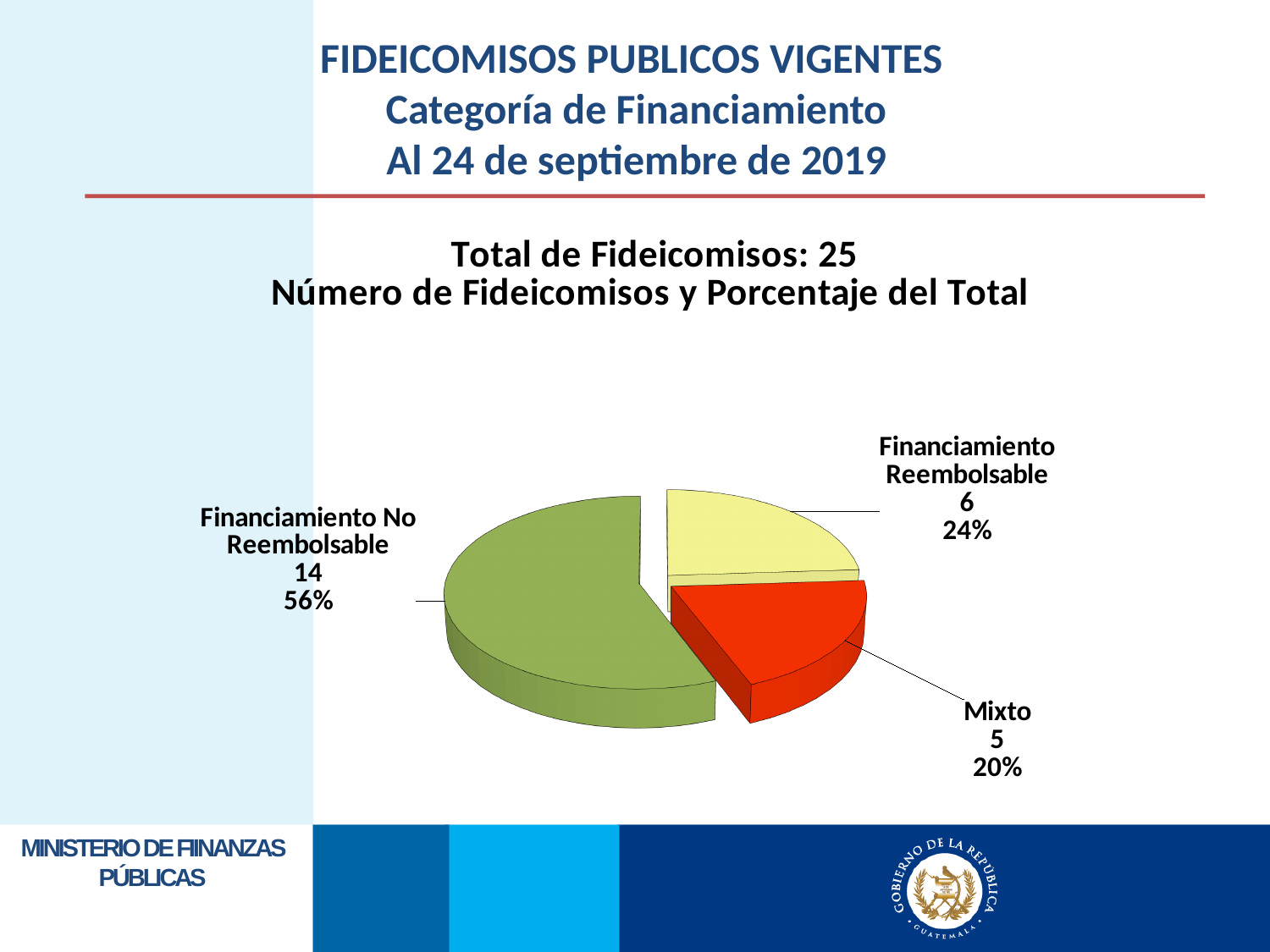
What share of the pie does Financiamiento No Reembolsable hold? 56% What percentage of the total does Financiamiento Reembolsable represent? 24% What is the total number of fideicomisos shown on the slide? 25 What kind of chart is shown on the slide? pie chart How many fideicomisos are in the Mixto category? 5 Which category has the smallest slice of the pie? Mixto How many fideicomisos are in the Financiamiento No Reembolsable category? 14 What colour is the Mixto slice of the pie? red How many slices does the pie chart have? 3 Which category has the largest slice of the pie? Financiamiento No Reembolsable What is the difference in number of fideicomisos between Financiamiento No Reembolsable and Financiamiento Reembolsable? 8 Which has more fideicomisos, Financiamiento Reembolsable or Mixto? Financiamiento Reembolsable